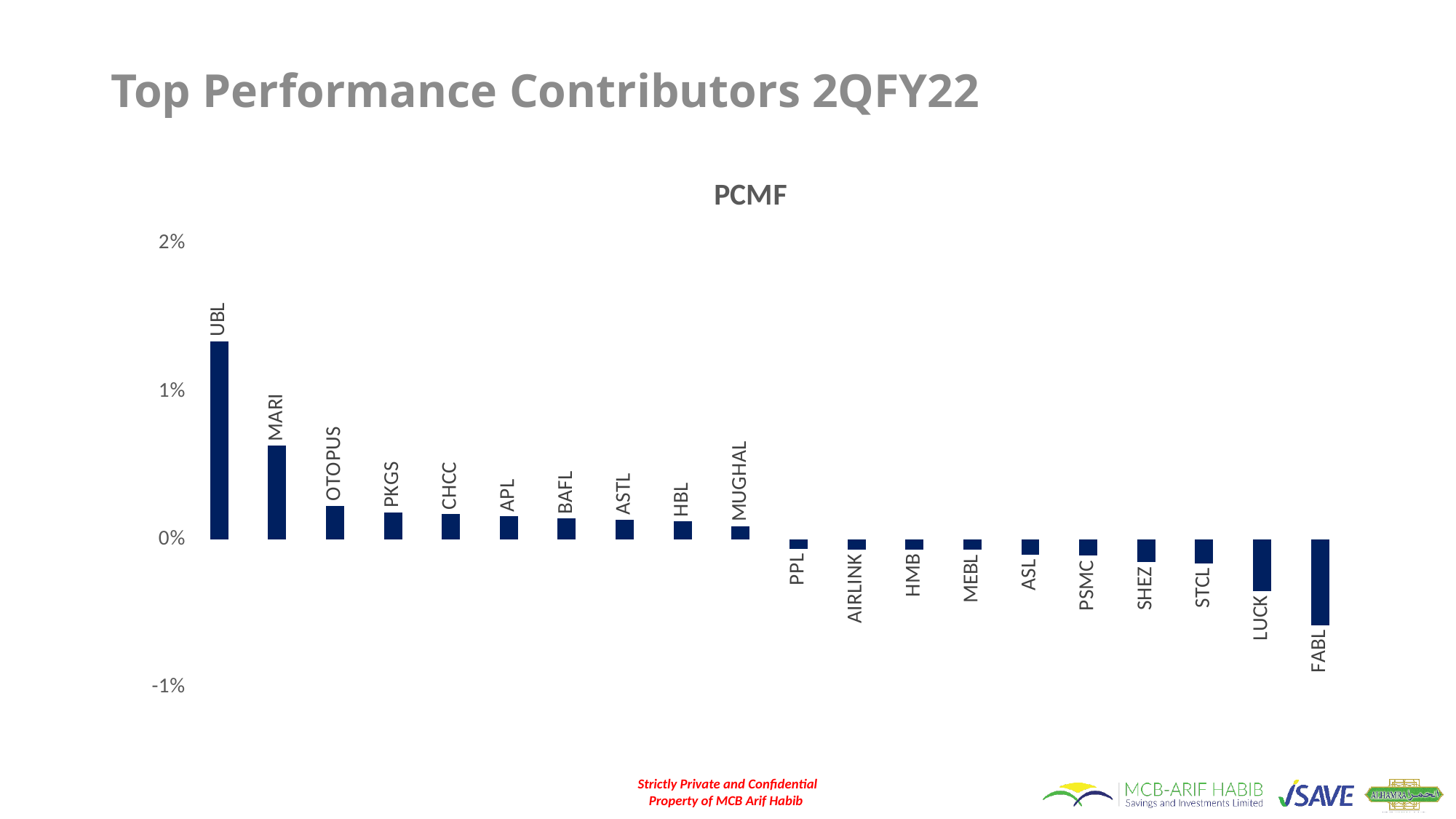
How many categories are plotted in the PCMF chart? 20 Is the value for LUCK greater or less than -1%? greater Which is larger, the value for LUCK or the value for FABL? LUCK Is the value for UBL greater or less than 1%? greater Is the value for MARI greater or less than 1%? less What is the title of the chart? PCMF Do the values generally rise or fall moving from left to right along the x axis? fall Which category has the highest value in the PCMF chart? UBL What type of chart is shown on the slide? bar chart Which category has the lowest value in the PCMF chart? FABL Which is larger, the value for UBL or the value for MARI? UBL